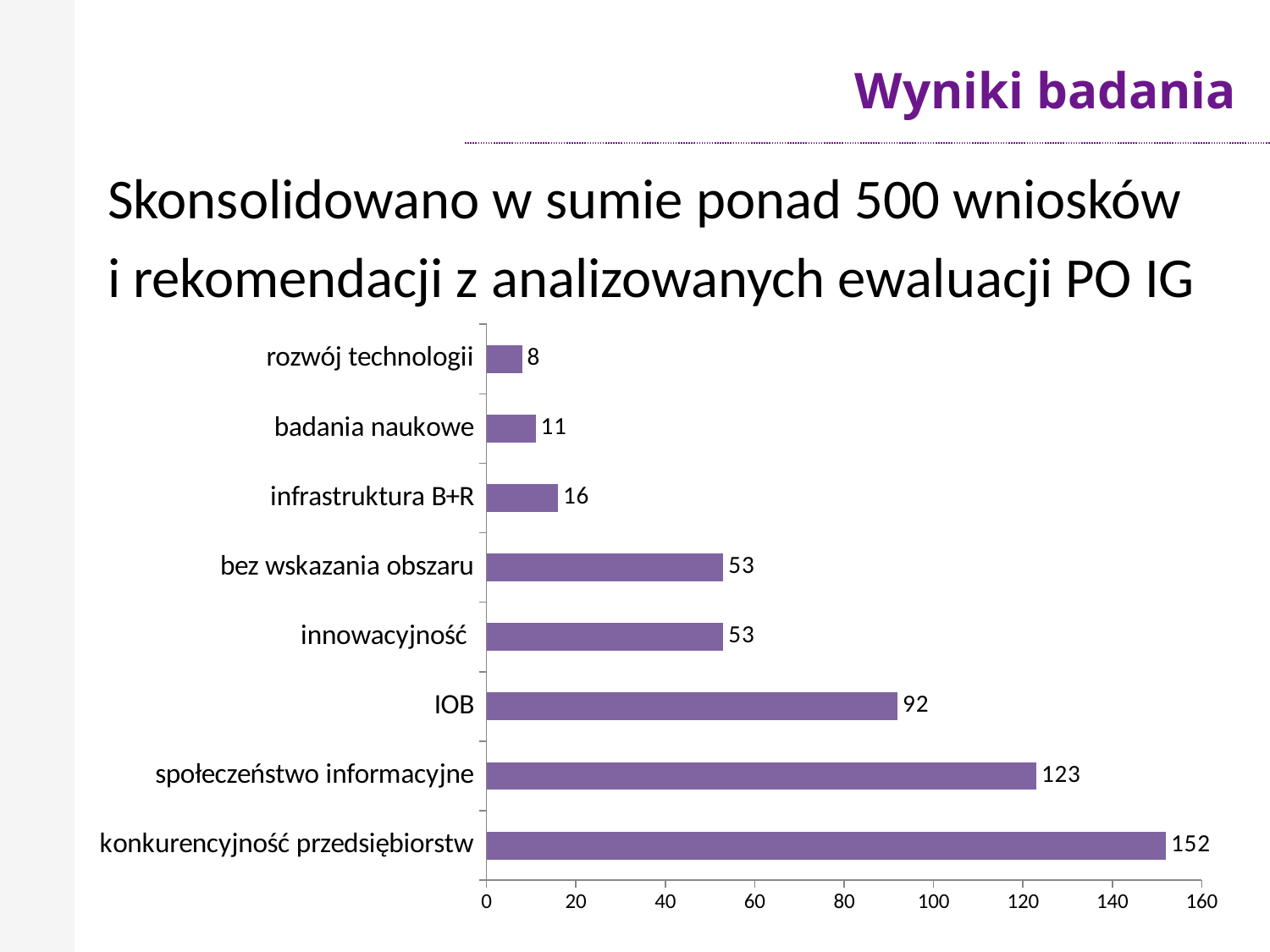
Which is larger, the value for badania naukowe or the value for infrastruktura B+R? infrastruktura B+R What is the value for infrastruktura B+R? 16 What is the difference between the values for IOB and innowacyjność? 39 What is the value for konkurencyjność przedsiębiorstw? 152 Which category has the highest value? konkurencyjność przedsiębiorstw What is the difference between the values for konkurencyjność przedsiębiorstw and społeczeństwo informacyjne? 29 Which category has the lowest value? rozwój technologii What is the value for IOB? 92 Is the value for społeczeństwo informacyjne greater or less than 100? greater How many categories are shown in the chart? 8 What kind of chart is shown on the slide? bar chart What is the highest value shown on the x axis? 160